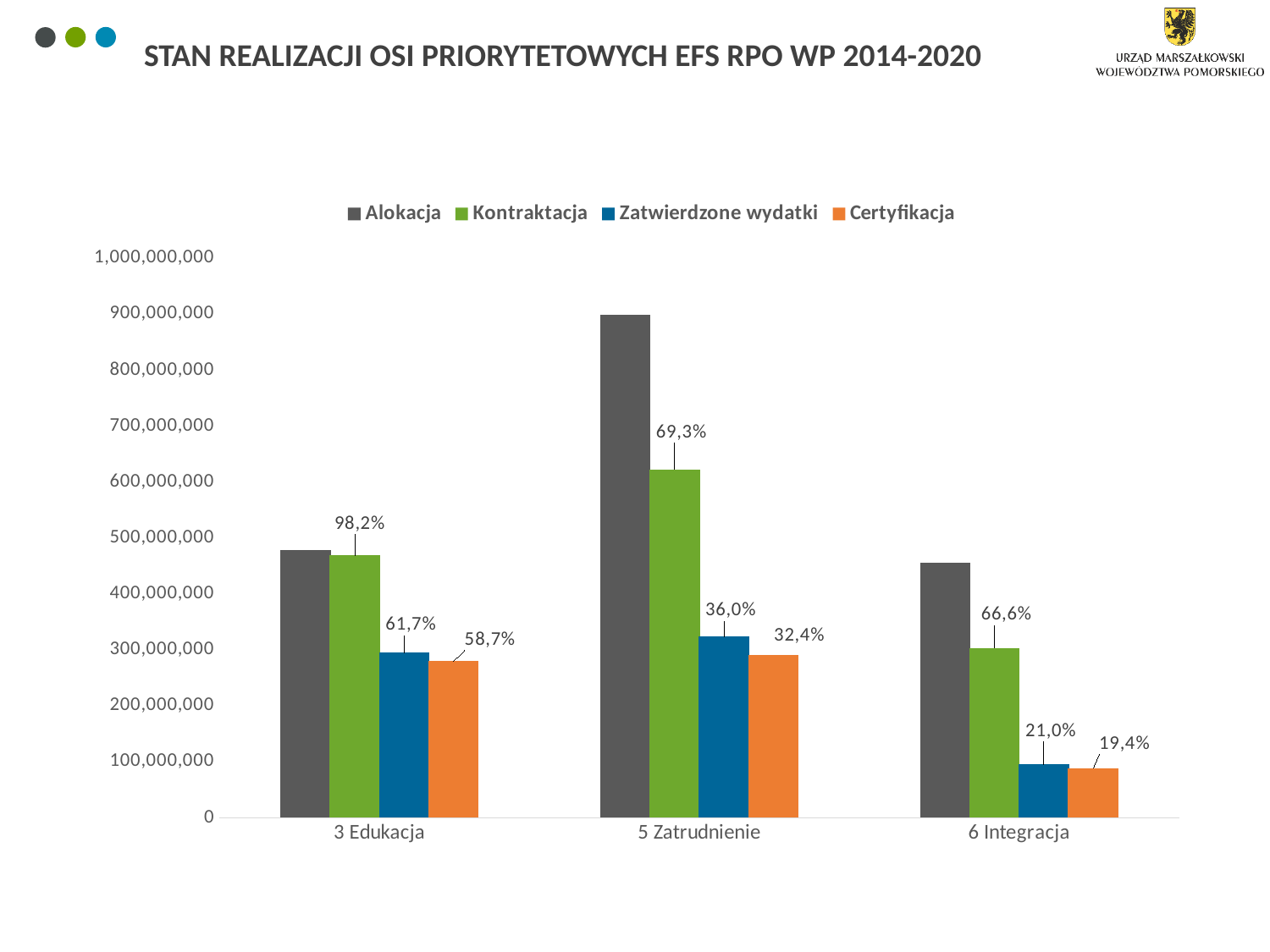
How many series does the legend list? 4 What percentage label is shown on the Kontraktacja bar for 3 Edukacja? 98,2% What percentage label is shown on the Zatwierdzone wydatki bar for 6 Integracja? 21,0% Which colour represents the Certyfikacja series in the legend? orange Which category has the lowest Certyfikacja value? 6 Integracja Which category has the highest Alokacja value? 5 Zatrudnienie What percentage label is shown on the Certyfikacja bar for 5 Zatrudnienie? 32,4% What kind of chart is shown on the slide? bar chart Which is larger, the Kontraktacja value for 3 Edukacja or for 6 Integracja? 3 Edukacja Is the Certyfikacja value for 6 Integracja greater or less than 100,000,000? less How many categories are shown on the x axis? 3 Is the Alokacja value for 5 Zatrudnienie greater or less than 800,000,000? greater